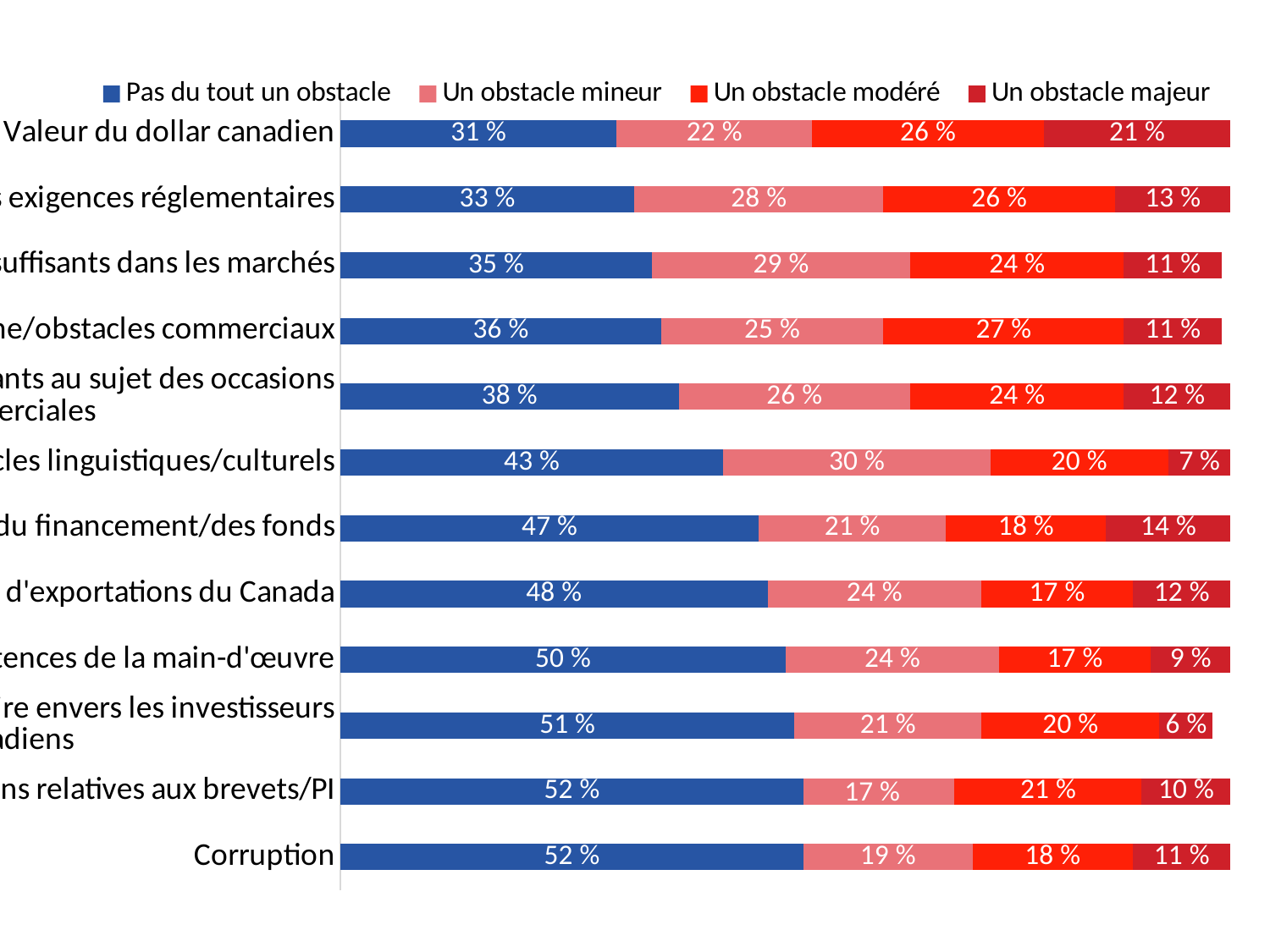
What percentage of respondents said the value of the Canadian dollar (Valeur du dollar canadien) is 'Pas du tout un obstacle'? 31 % What is the 'Pas du tout un obstacle' value for Corruption? 52 % What is the 'Un obstacle majeur' value for Valeur du dollar canadien? 21 % Which category has the highest 'Un obstacle majeur' value? Valeur du dollar canadien How many percentage points higher is the 'Pas du tout un obstacle' value for Corruption than for Valeur du dollar canadien? 21 percentage points What kind of chart is shown on the slide? Stacked bar chart How many categories (bars) are shown in the chart? 12 Which category has the lowest 'Pas du tout un obstacle' value? Valeur du dollar canadien How many series does the legend list? 4 What is the 'Un obstacle majeur' value for Corruption? 11 % What is the total of the four segments in the Corruption bar? 100 % Which has the larger 'Un obstacle modéré' value: Corruption or Valeur du dollar canadien? Valeur du dollar canadien